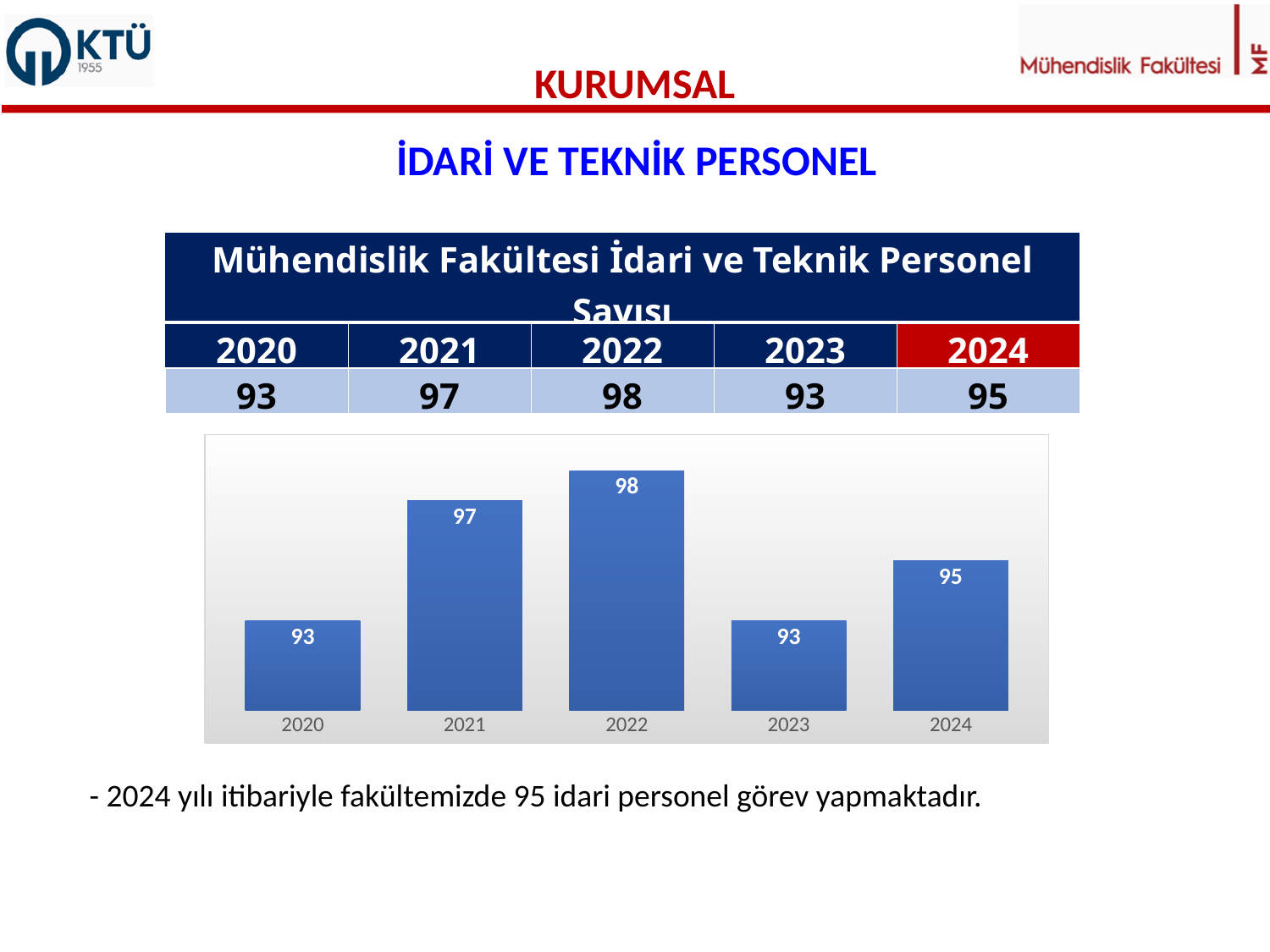
Which is larger in the bar chart, the value for 2021 or the value for 2024? 2021 What is the value shown for 2021 in the bar chart? 97 What is the value shown for 2024 in the bar chart? 95 What is the value shown for 2022 in the bar chart? 98 What is the difference between the values for 2022 and 2020 in the bar chart? 5 What is the difference between the values for 2024 and 2023 in the bar chart? 2 Which two years share the same value of 93 in the bar chart? 2020 and 2023 How many years are shown on the x axis of the bar chart? 5 Does the value rise or fall from 2022 to 2023 in the bar chart? fall Which year has the highest value in the bar chart? 2022 What is the title of the table above the bar chart? Mühendislik Fakültesi İdari ve Teknik Personel Sayısı What kind of chart is shown on the slide? bar chart